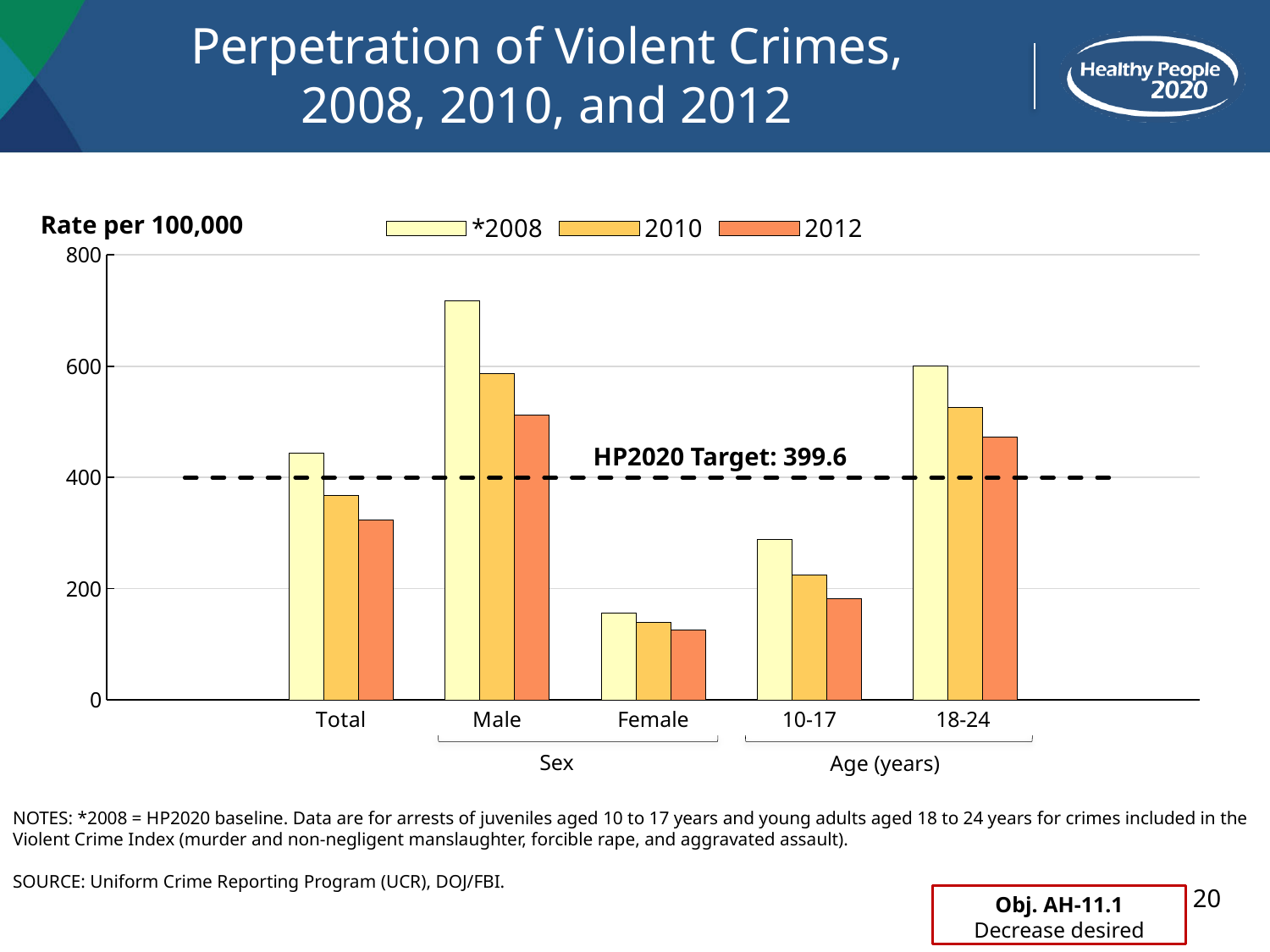
Which category has the lowest value for 2012? Female How many series does the legend list? 3 Which category has the highest value for 2008? Male Is the value for Female in 2008 greater or less than 200? less What is the HP2020 Target value shown on the chart? 399.6 Within the Total category, do the values rise or fall from 2008 to 2012? fall Which is larger, the 2010 value for Male or the 2010 value for 18-24? Male How many categories are shown along the x axis? 5 What is the label of the y axis? Rate per 100,000 Is the value for Male in 2008 greater or less than 600? greater What kind of chart is shown on the slide? bar chart Is the value for Total in 2012 greater or less than 400? less